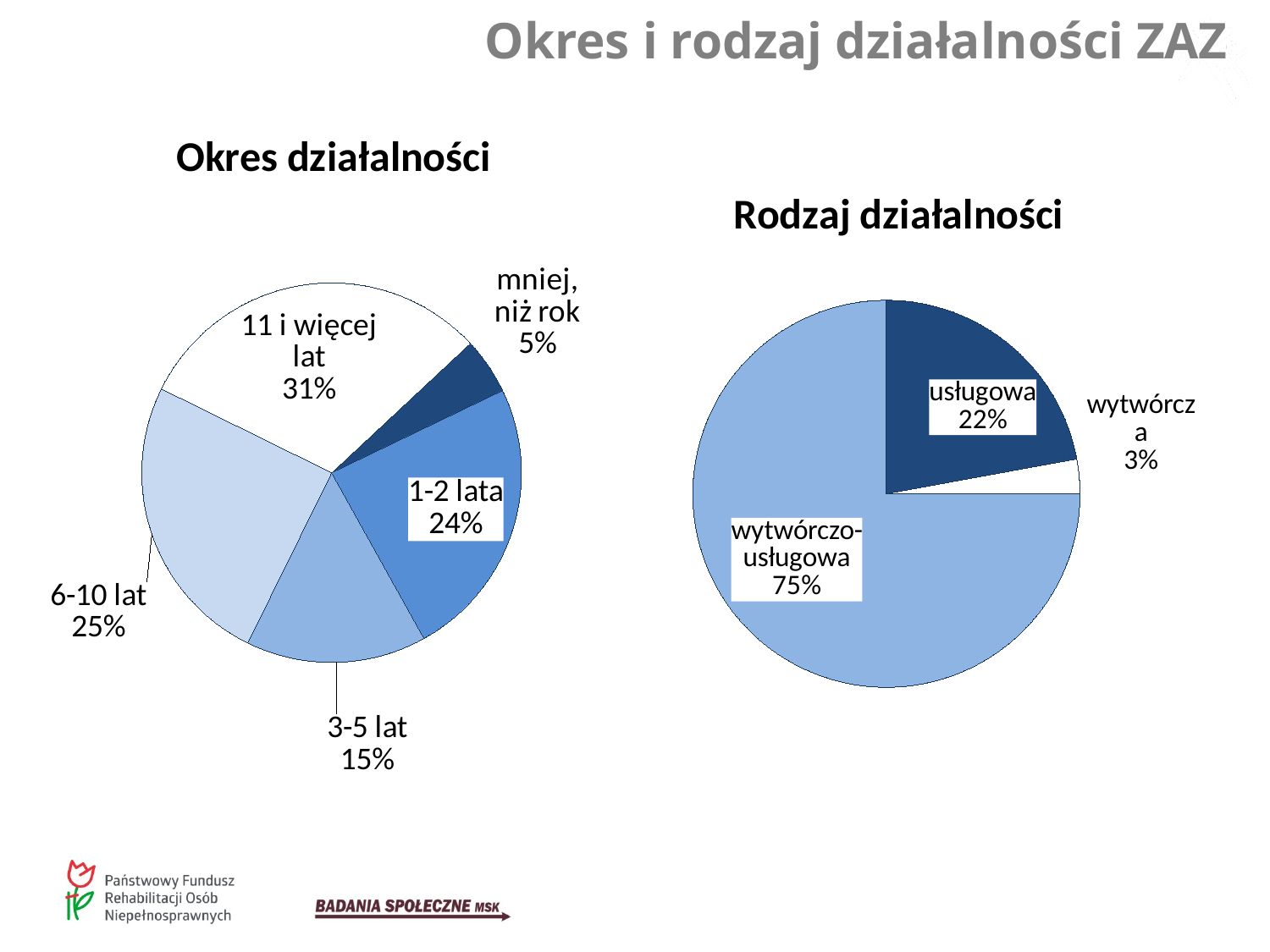
In the 'Okres działalności' chart, which category has the largest slice? 11 i więcej lat In the 'Rodzaj działalności' chart, what is the difference between the shares for 'wytwórczo-usługowa' and 'usługowa'? 53% In the 'Okres działalności' chart, what share is shown for '11 i więcej lat'? 31% In the 'Okres działalności' chart, what share is shown for '3-5 lat'? 15% In the 'Okres działalności' chart, what is the difference between the shares for '6-10 lat' and '1-2 lata'? 1% In the 'Rodzaj działalności' chart, which category has the largest slice? wytwórczo-usługowa In the 'Rodzaj działalności' chart, what share is shown for 'wytwórcza'? 3% What type of chart is the 'Rodzaj działalności' chart? Pie chart In the 'Okres działalności' chart, how many slices does the pie have? 5 What is the title of the slide? Okres i rodzaj działalności ZAZ In the 'Rodzaj działalności' chart, what share is shown for 'usługowa'? 22% In the 'Okres działalności' chart, which category has the smallest slice? mniej, niż rok